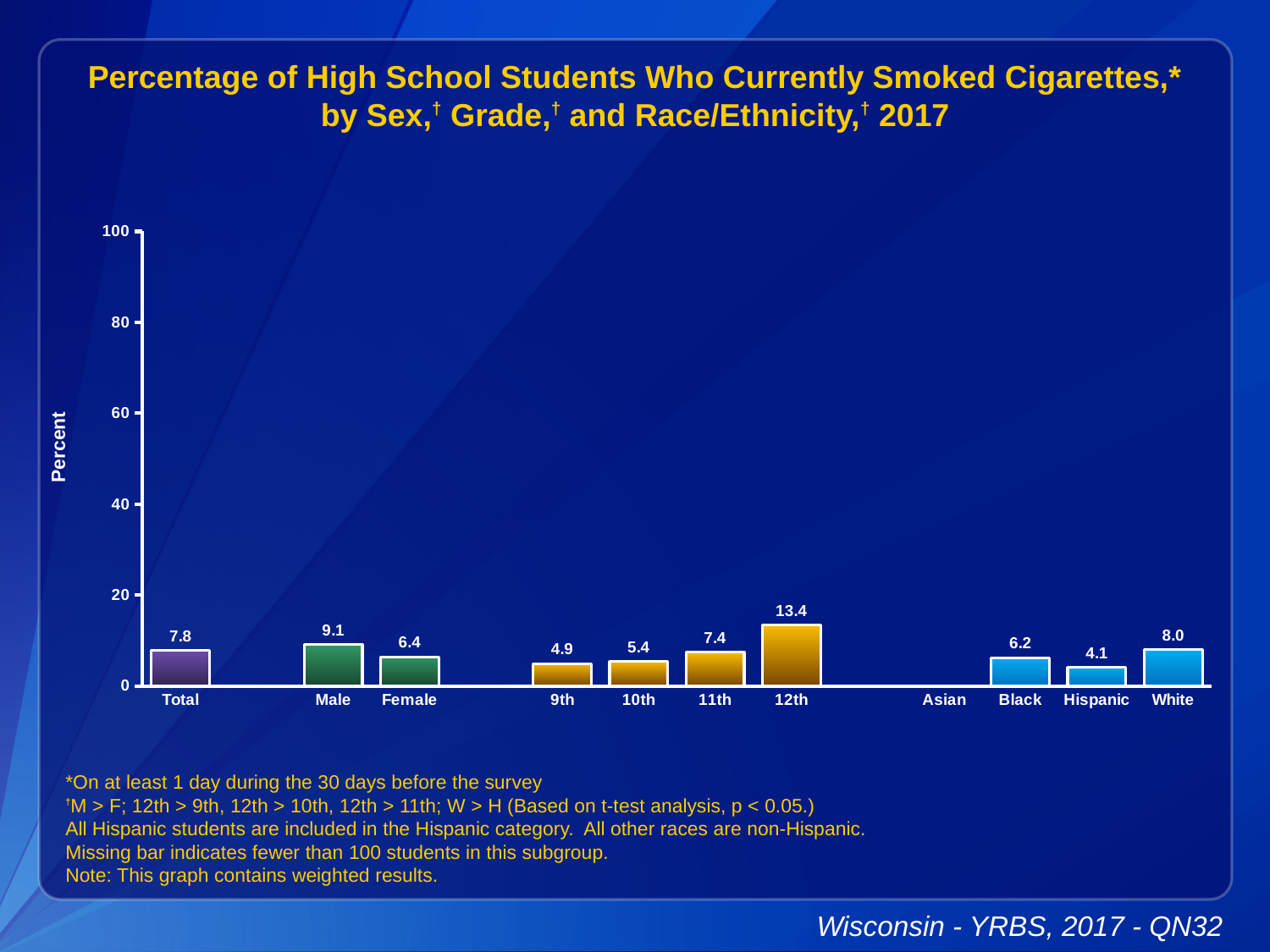
Which category with a bar has the lowest value? Hispanic Which category has the highest value? 12th What is the value for 12th grade? 13.4 What is the value for Hispanic? 4.1 How many categories have a bar plotted? 10 Which is larger, the value for White or the value for Black? White Is the value for 12th grade greater or less than 20? less What is the value for Total? 7.8 Which category has no bar shown? Asian What is the value for Male? 9.1 What is the difference between the Male and Female values? 2.7 What kind of chart is this? bar chart